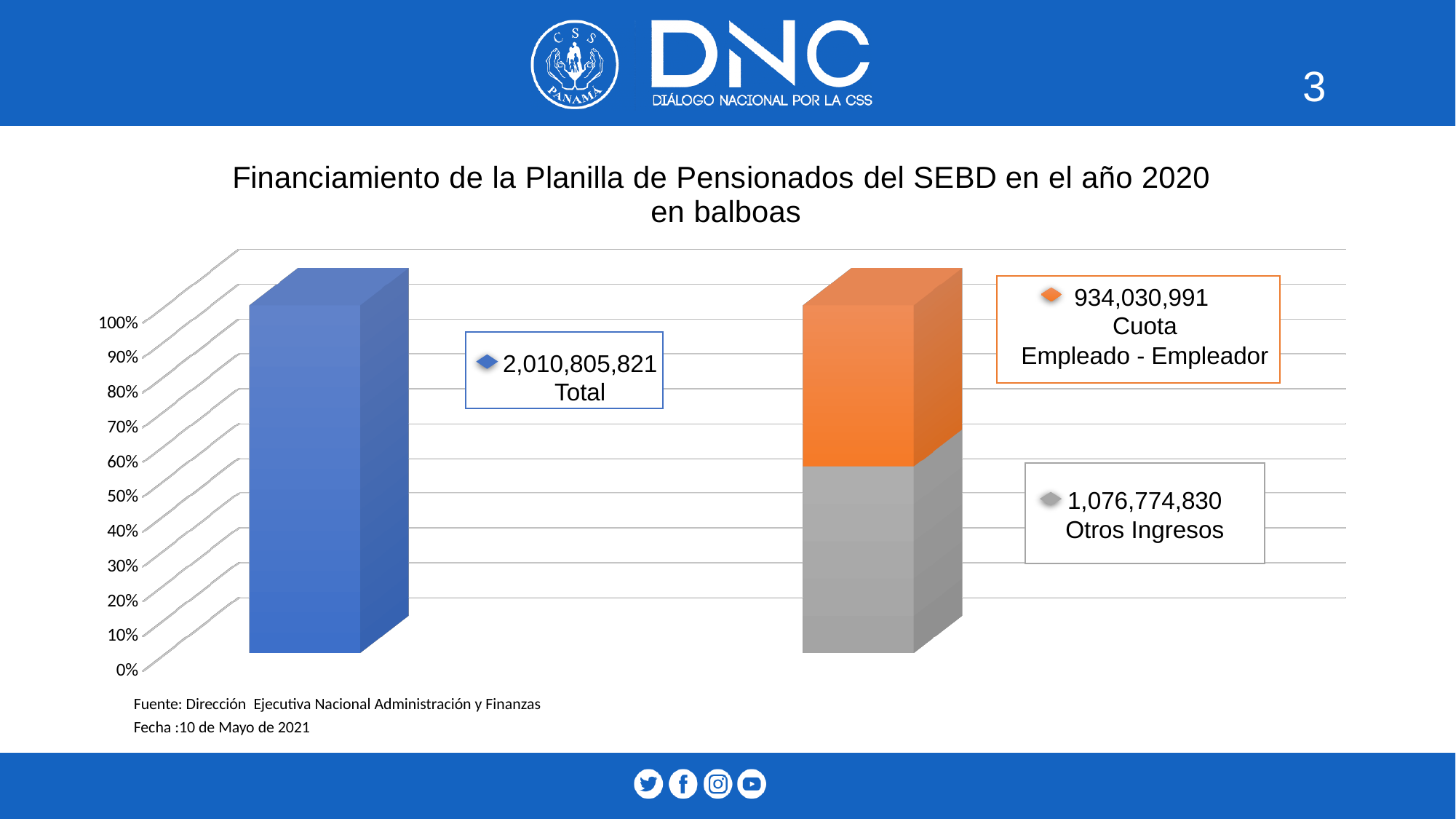
Which of the labelled components is the smallest value? Cuota Empleado - Empleador What is the total of the stacked bar made up of Cuota Empleado - Empleador and Otros Ingresos? 2,010,805,821 What kind of chart is shown on the slide? Bar chart What is the difference between Otros Ingresos and Cuota Empleado - Empleador? 142,743,839 What is the value for Cuota Empleado - Empleador? 934,030,991 How many bars are plotted in the chart? 2 Which is larger, Otros Ingresos or Cuota Empleado - Empleador? Otros Ingresos What is the value labelled Total? 2,010,805,821 What is the value for Otros Ingresos? 1,076,774,830 What source is cited below the chart? Dirección Ejecutiva Nacional Administración y Finanzas What is the title of the chart? Financiamiento de la Planilla de Pensionados del SEBD en el año 2020 en balboas How many segments make up the right-hand stacked bar? 2